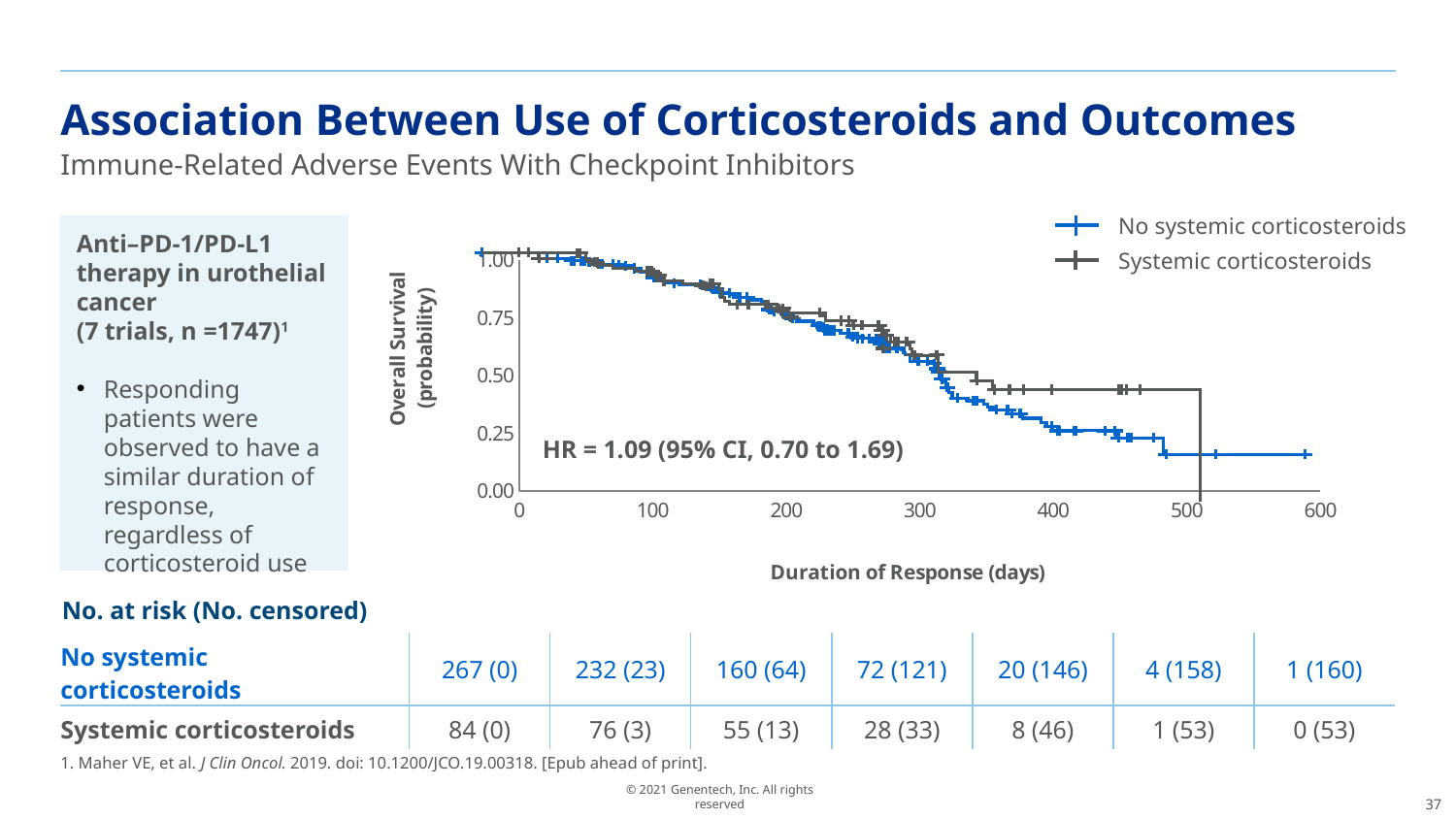
At 0 days, how many more patients were at risk in the No systemic corticosteroids group than in the Systemic corticosteroids group? 183 Is the overall survival probability for Systemic corticosteroids at 100 days greater or less than 0.75? greater What hazard ratio is printed on the chart? HR = 1.09 (95% CI, 0.70 to 1.69) What kind of chart is shown on the slide? line chart How many series does the legend list? 2 What is the label of the x axis? Duration of Response (days) In the number-at-risk table, how many No systemic corticosteroids patients were at risk at 0 days? 267 At 400 days, which curve is higher: No systemic corticosteroids or Systemic corticosteroids? Systemic corticosteroids In the number-at-risk table, what is the entry for Systemic corticosteroids at 200 days? 55 (13) What are the two series named in the legend? No systemic corticosteroids; Systemic corticosteroids Is the overall survival probability for No systemic corticosteroids at 400 days greater or less than 0.50? less Do the survival curves rise or fall as duration of response increases? fall